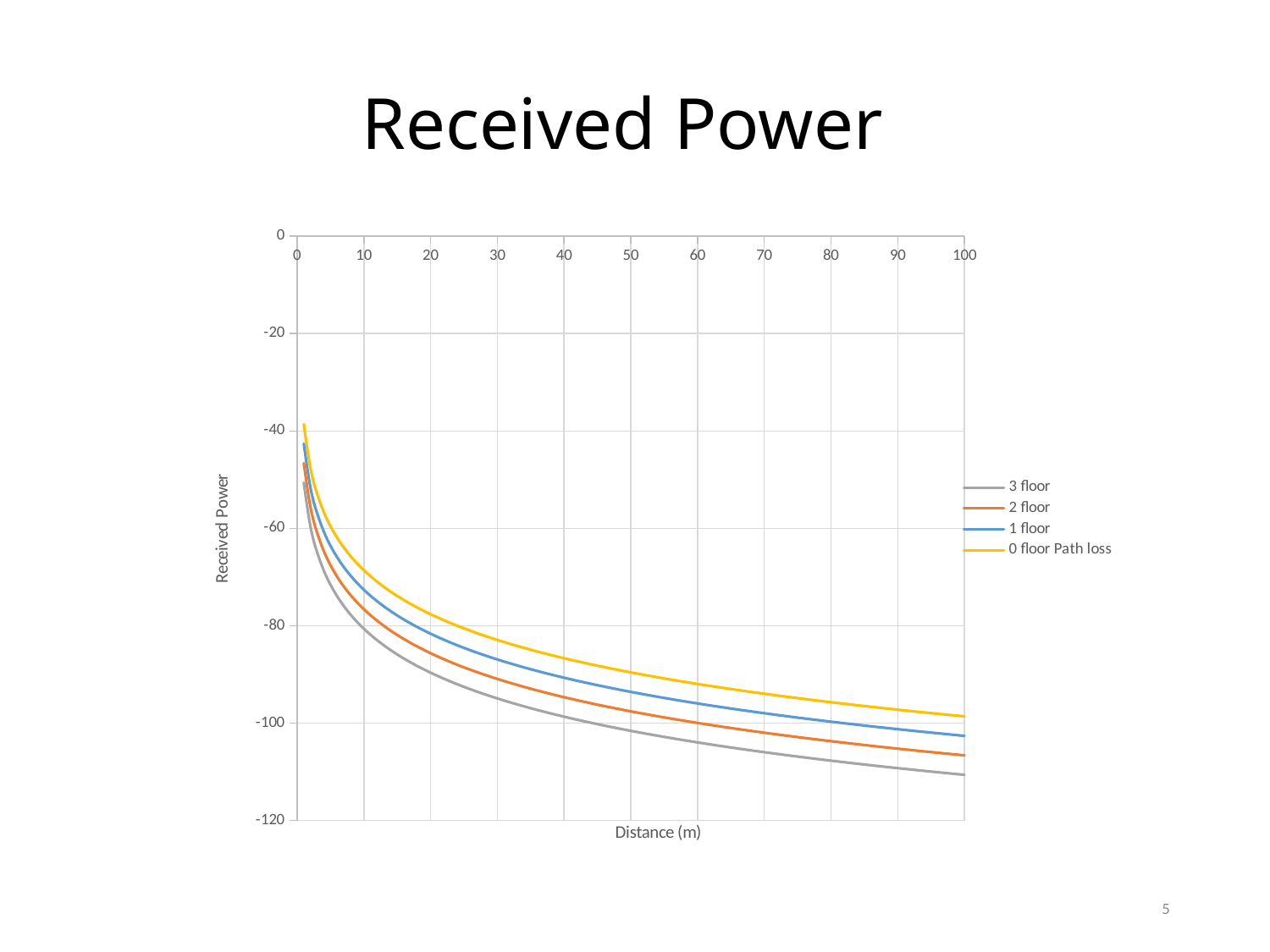
At a distance of 100 m, which is larger: the value for 0 floor Path loss or the value for 3 floor? 0 floor Path loss Which series has the highest received power across the distance range? 0 floor Path loss Do the values of the 0 floor Path loss series rise or fall along the x axis? fall At a distance of 100 m, is the value for 0 floor Path loss greater or less than -100? greater How many series does the legend list? 4 What is the title of the chart? Received Power What kind of chart is shown on the slide? line chart Which series has the lowest received power across the distance range? 3 floor Do the values of the 3 floor series rise or fall as distance increases? fall At a distance of 20 m, is the value for 3 floor greater or less than -80? less What is the label of the x axis? Distance (m) At a distance of 100 m, is the value for 3 floor greater or less than -100? less